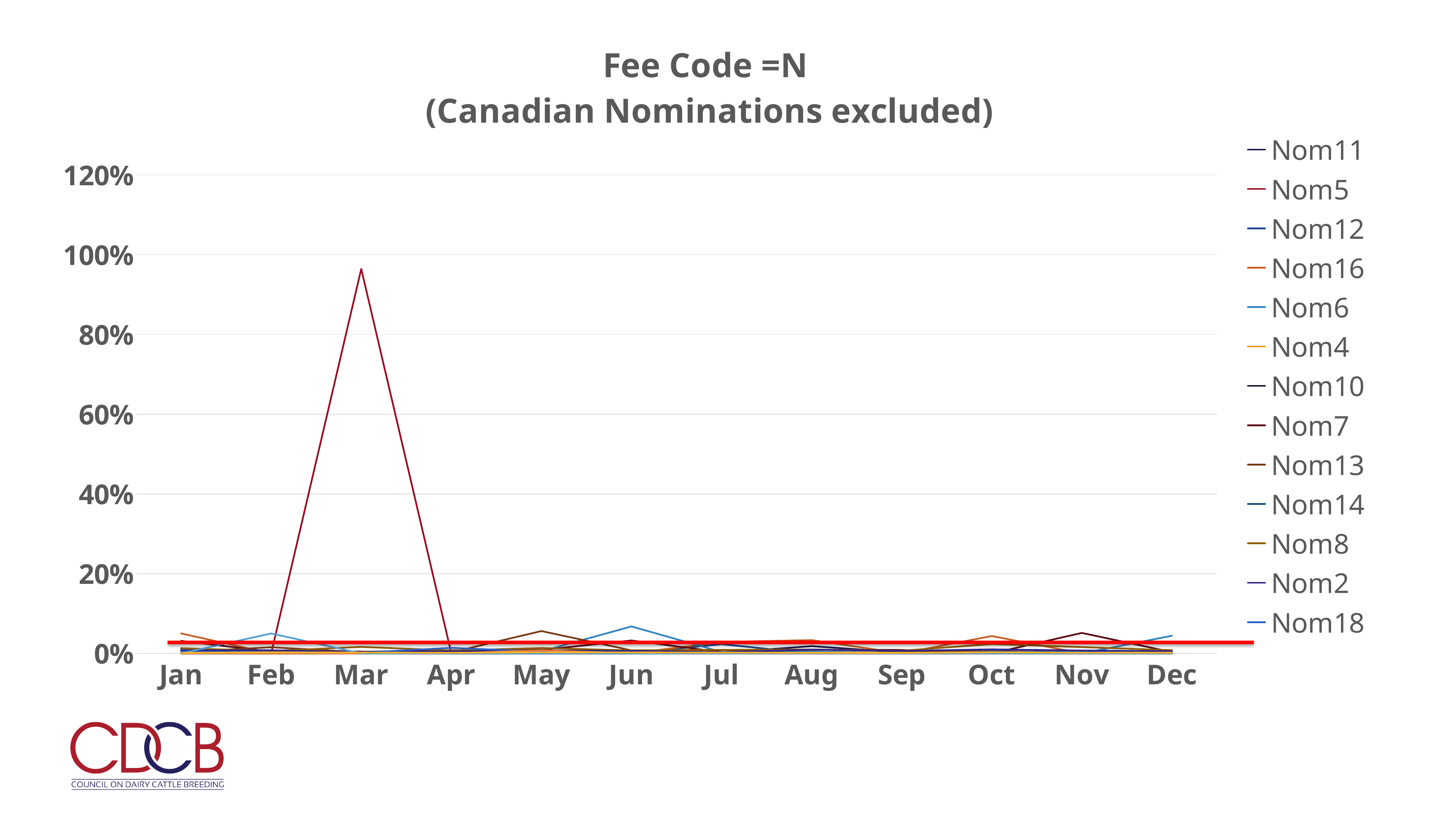
What is the highest tick label shown on the y axis? 120% Is the peak value in Mar greater or less than 60%? greater Are all the plotted values in Jan greater or less than 20%? less Is the peak value in Mar greater or less than 100%? less How many months are shown along the x axis of the chart? 12 How many series does the chart's legend list? 13 What is the first series listed in the chart's legend? Nom11 What is the first month shown on the x axis? Jan What is the title of the chart? Fee Code =N (Canadian Nominations excluded) In which month does the chart reach its highest value? Mar What kind of chart is shown on the slide? line chart